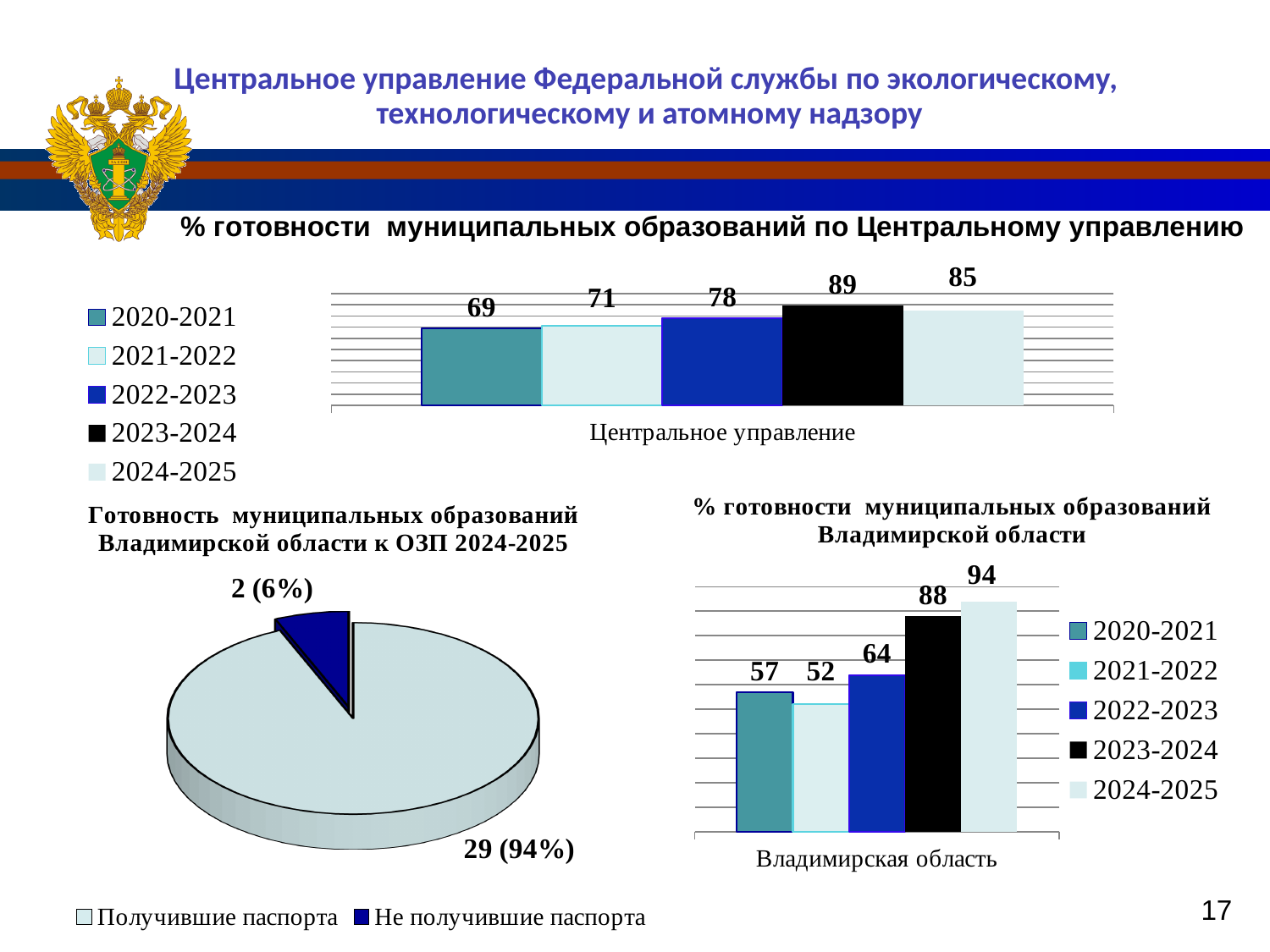
In the bottom-right chart '% готовности муниципальных образований Владимирской области', what is the difference between the 2023-2024 and 2022-2023 values? 24 In the bottom-right chart '% готовности муниципальных образований Владимирской области', which is larger: the value for 2020-2021 or 2021-2022? 2020-2021 In the pie chart 'Готовность муниципальных образований Владимирской области к ОЗП 2024-2025', what is the value for 'Получившие паспорта'? 29 (94%) What kind of chart is 'Готовность муниципальных образований Владимирской области к ОЗП 2024-2025'? Pie chart In the pie chart 'Готовность муниципальных образований Владимирской области к ОЗП 2024-2025', what share does 'Не получившие паспорта' have? 6% In the top chart '% готовности муниципальных образований по Центральному управлению', what is the value for 2022-2023? 78 In the top chart '% готовности муниципальных образований по Центральному управлению', which series has the lowest value? 2020-2021 In the top chart '% готовности муниципальных образований по Центральному управлению', how many series does the legend list? 5 In the bottom-right chart '% готовности муниципальных образований Владимирской области', which series has the highest value? 2024-2025 In the top chart '% готовности муниципальных образований по Центральному управлению', which series has the highest value? 2023-2024 In the top chart '% готовности муниципальных образований по Центральному управлению', what is the difference between the 2023-2024 and 2024-2025 values? 4 In the bottom-right chart '% готовности муниципальных образований Владимирской области', what is the value for 2021-2022? 52